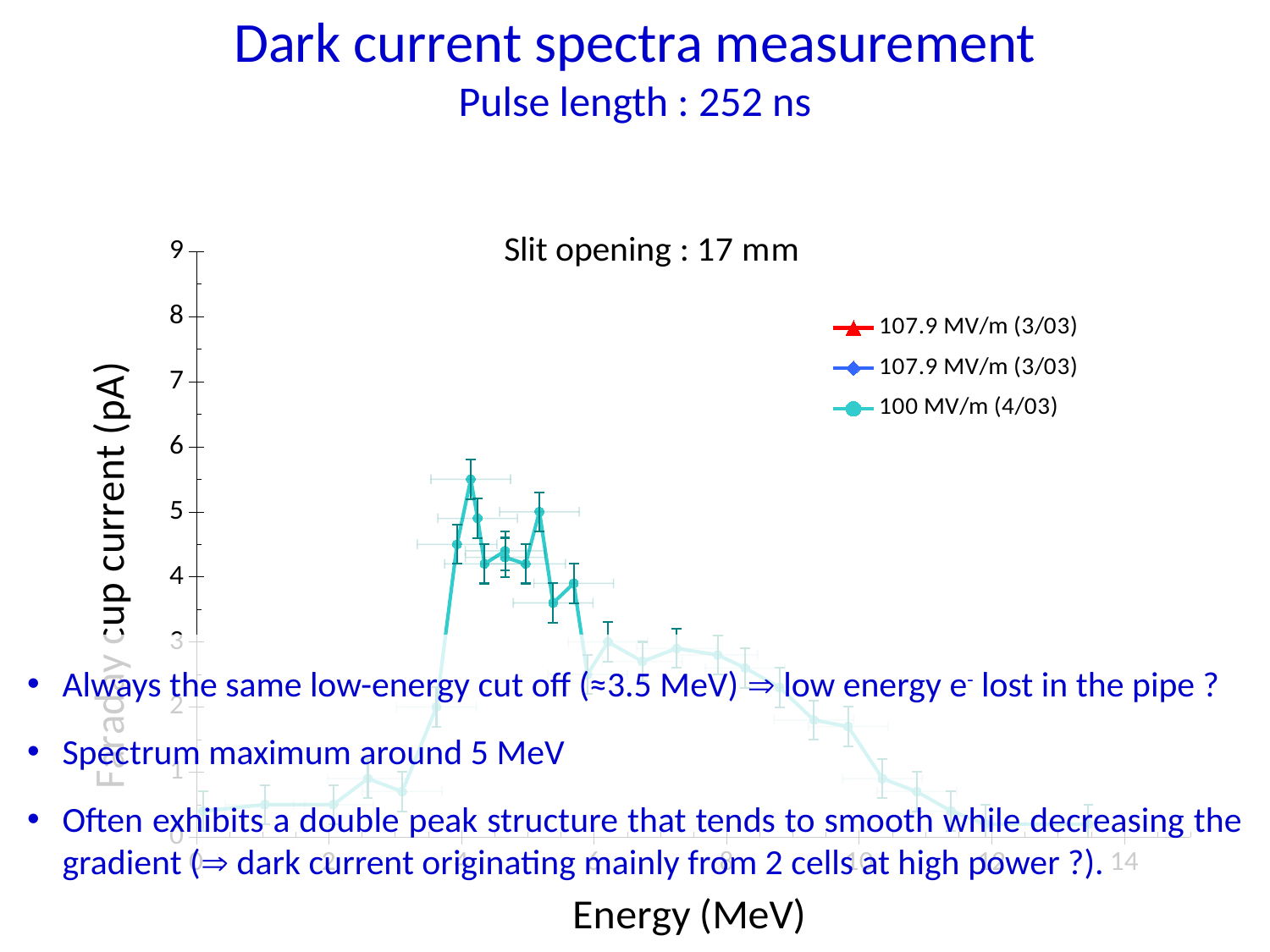
How many series does the legend list? 3 Is the highest value of the 100 MV/m (4/03) series greater or less than 5? greater Do the values of the 100 MV/m (4/03) series rise or fall as energy increases from 3 MeV to 4 MeV? rise Is the highest value of the 100 MV/m (4/03) series greater or less than 6? less Is the value of the 100 MV/m (4/03) series at 9 MeV greater or less than 3? less What kind of chart is shown on the slide? line chart Do the values of the 100 MV/m (4/03) series rise or fall as energy increases from 6 MeV to 13 MeV? fall What is the label of the x axis? Energy (MeV) What is the title of the chart? Slit opening : 17 mm